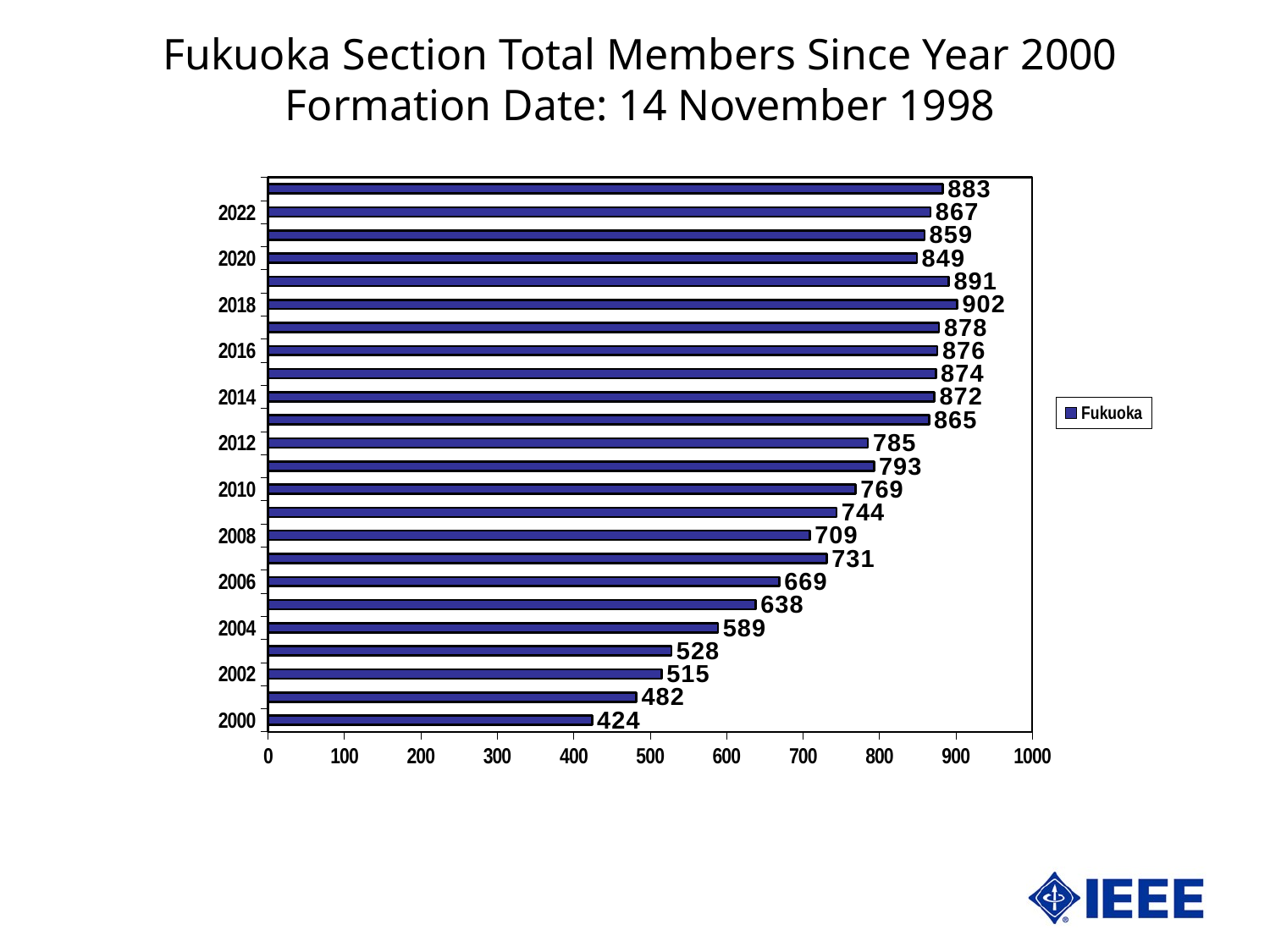
What series name is shown in the legend? Fukuoka What is the value for 2000? 424 What is the difference between the values for 2018 and 2000? 478 What is the value for 2018? 902 What kind of chart is shown on the slide? bar chart How many series does the legend list? 1 What is the value for 2022? 867 Which year has the highest value? 2018 How many bars are plotted in the chart? 24 What is the value for 2010? 769 Which is larger, the value for 2020 or the value for 2016? 2016 Which year has the lowest value? 2000